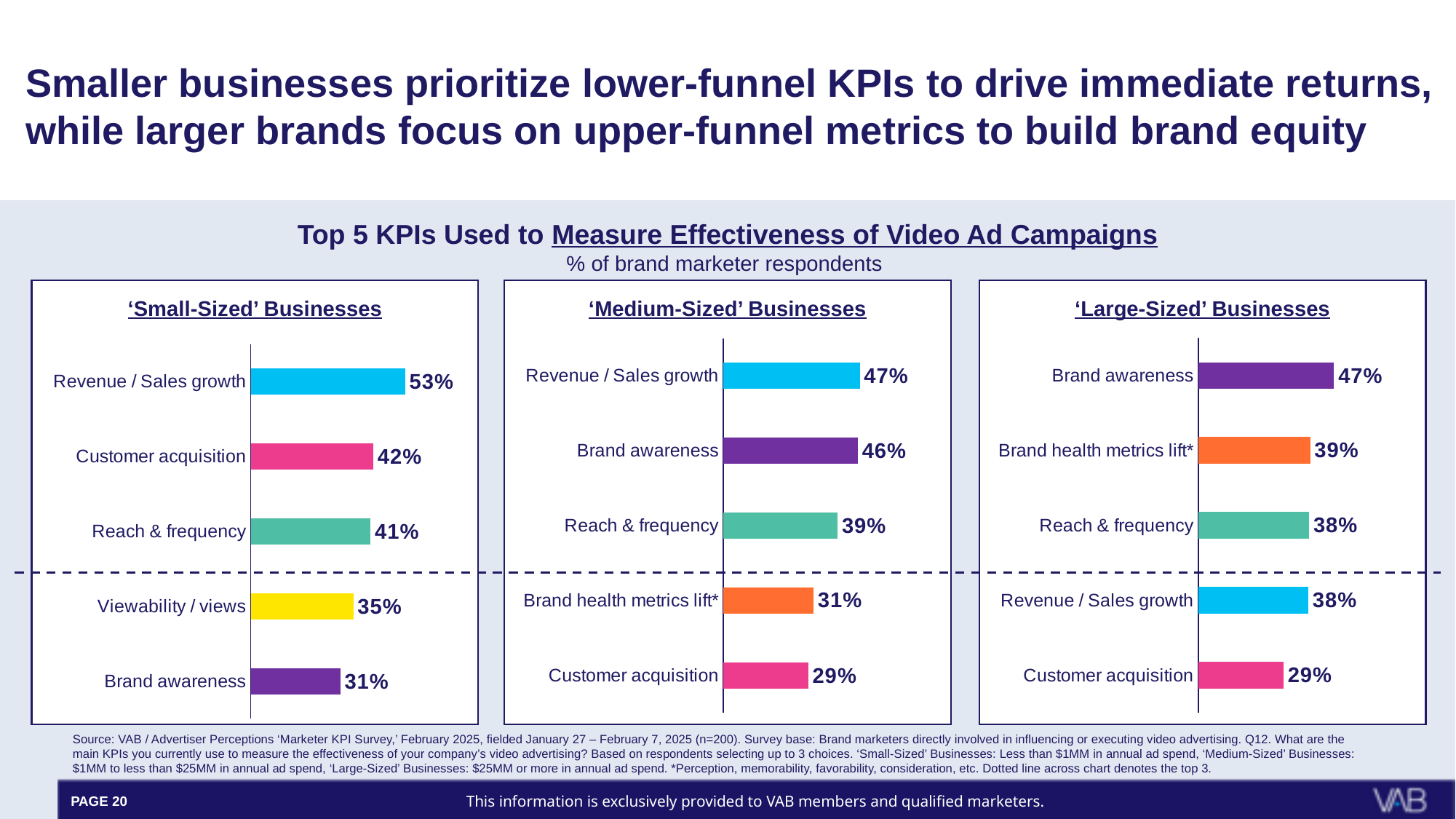
In the 'Medium-Sized' Businesses chart, what is the value for Brand awareness? 46% In the 'Medium-Sized' Businesses chart, which KPI has the lowest value? Customer acquisition In the 'Medium-Sized' Businesses chart, what is the difference between Reach & frequency and Brand health metrics lift*? 8 percentage points In the 'Small-Sized' Businesses chart, which is larger: Customer acquisition or Viewability / views? Customer acquisition In the 'Small-Sized' Businesses chart, what is the difference between Revenue / Sales growth and Brand awareness? 22 percentage points What is the title of the overall chart section on the slide? Top 5 KPIs Used to Measure Effectiveness of Video Ad Campaigns How many KPIs are shown in the 'Large-Sized' Businesses chart? 5 What type of chart is used for the 'Medium-Sized' Businesses data? Bar chart In the 'Small-Sized' Businesses chart, which KPI has the lowest value? Brand awareness In the 'Small-Sized' Businesses chart, what percentage of respondents use Revenue / Sales growth as a KPI? 53% In the 'Large-Sized' Businesses chart, which KPI has the highest value? Brand awareness In the 'Large-Sized' Businesses chart, what is the value for Brand health metrics lift*? 39%